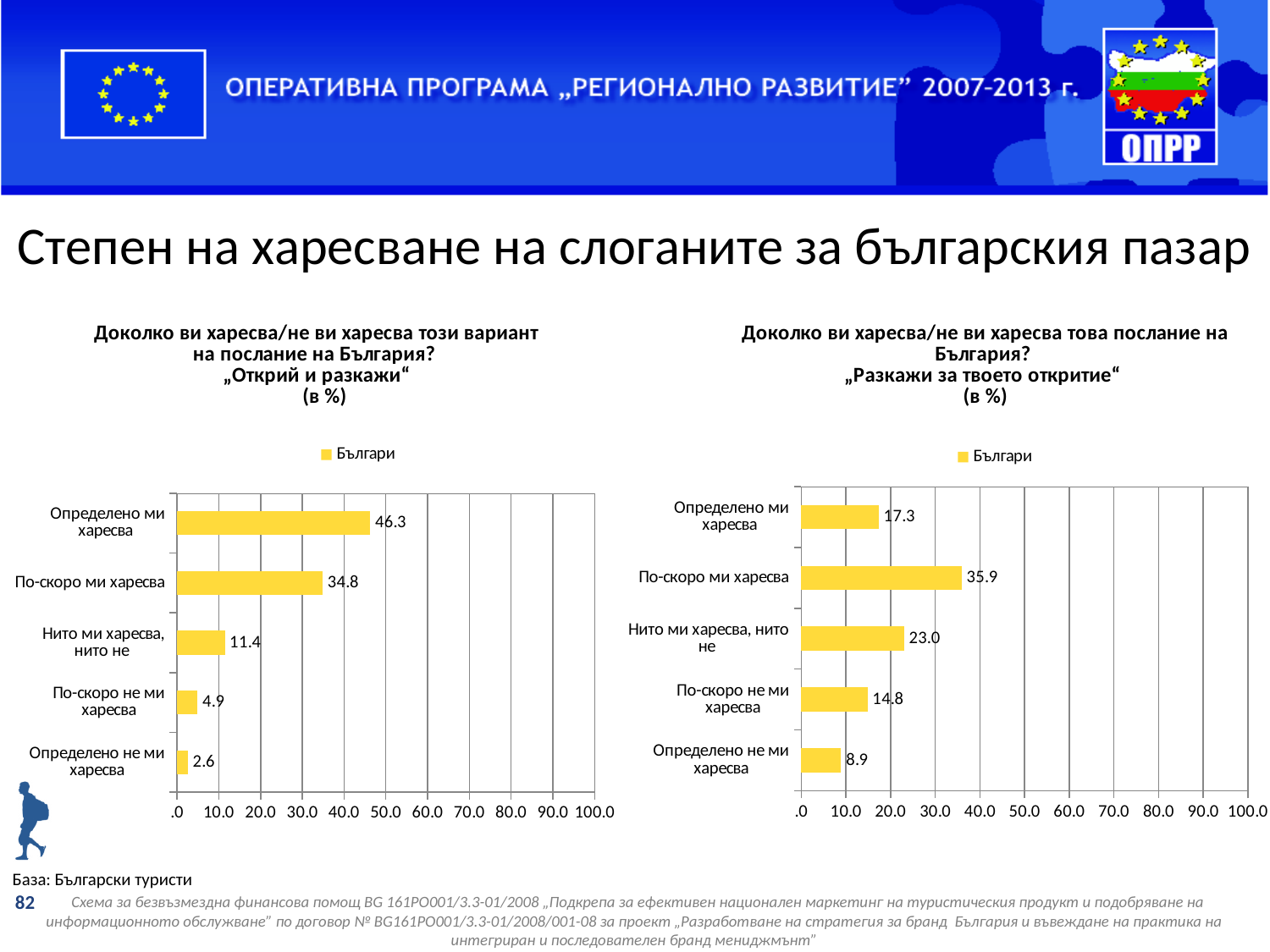
In the right chart („Разкажи за твоето откритие“), which category has the highest value? По-скоро ми харесва In the left chart („Открий и разкажи“), which category has the lowest value? Определено не ми харесва In the right chart („Разкажи за твоето откритие“), what is the difference between „Нито ми харесва, нито не“ and „По-скоро не ми харесва“? 8.2 In the left chart („Открий и разкажи“), what is the difference between „Определено ми харесва“ and „По-скоро ми харесва“? 11.5 How many series does the legend of the left chart („Открий и разкажи“) list? 1 In the right chart („Разкажи за твоето откритие“), what is the value for „Определено не ми харесва“? 8.9 What type of chart is the left chart („Открий и разкажи“)? Bar chart In the left chart („Открий и разкажи“), what is the value for „Определено ми харесва“? 46.3 In the right chart („Разкажи за твоето откритие“), what is the value for „По-скоро ми харесва“? 35.9 Which is larger: „Определено ми харесва“ in the left chart or „Определено ми харесва“ in the right chart? Left chart (46.3) In the left chart („Открий и разкажи“), is the value for „Нито ми харесва, нито не“ greater or less than 20.0? less How many categories does the right chart („Разкажи за твоето откритие“) show? 5